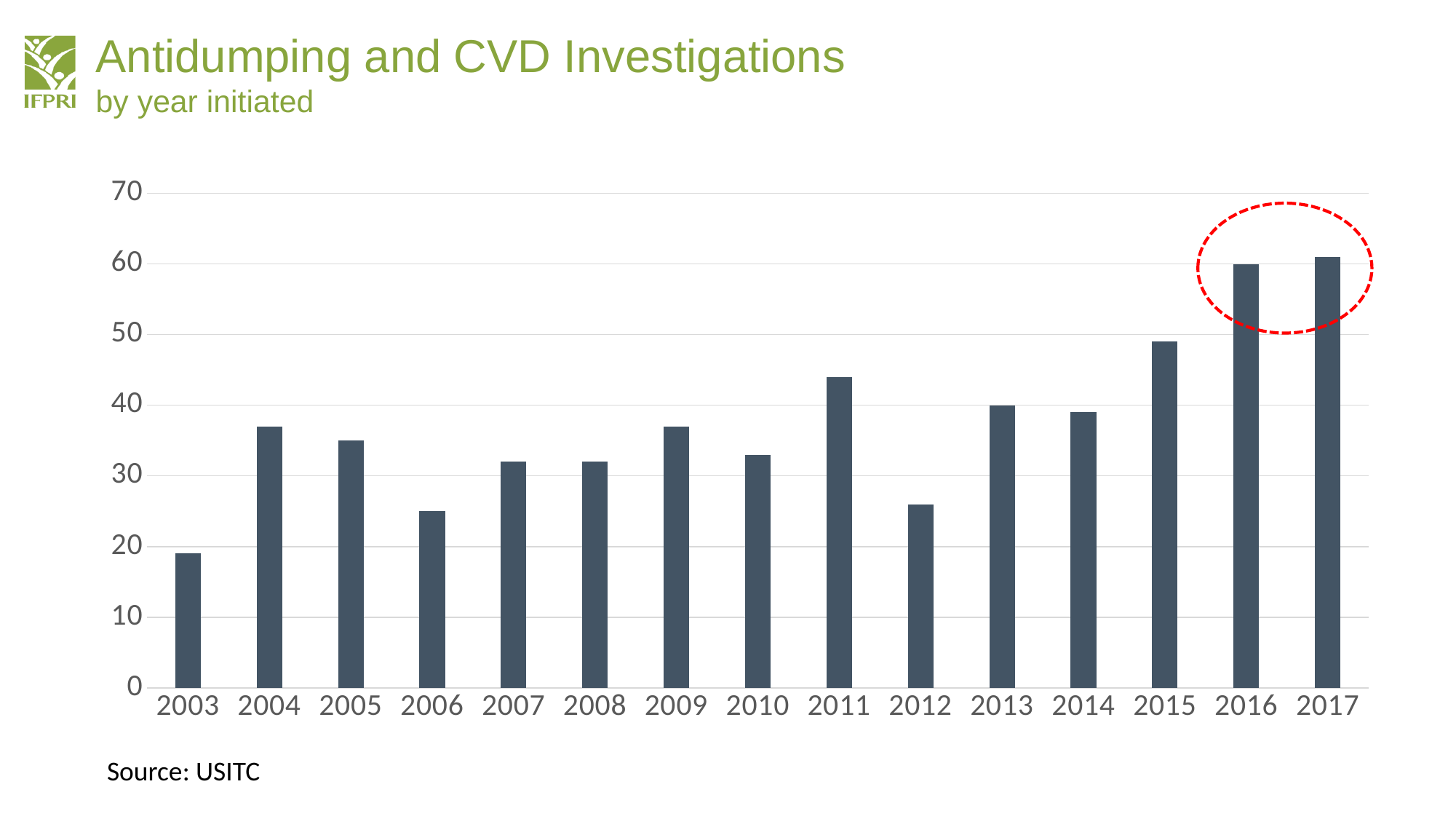
Which two years are highlighted with a red dashed circle on the chart? 2016 and 2017 Which year has the larger value, 2011 or 2012? 2011 Is the value for 2003 greater or less than 20? less Is the value for 2011 greater or less than 40? greater What kind of chart is shown on the slide? bar chart Which year has the larger value, 2006 or 2007? 2007 Is the value for 2015 greater or less than 50? less Which year has the lowest number of investigations? 2003 Overall, do the values rise or fall from 2003 to 2017? rise How many years are shown on the x axis of the chart? 15